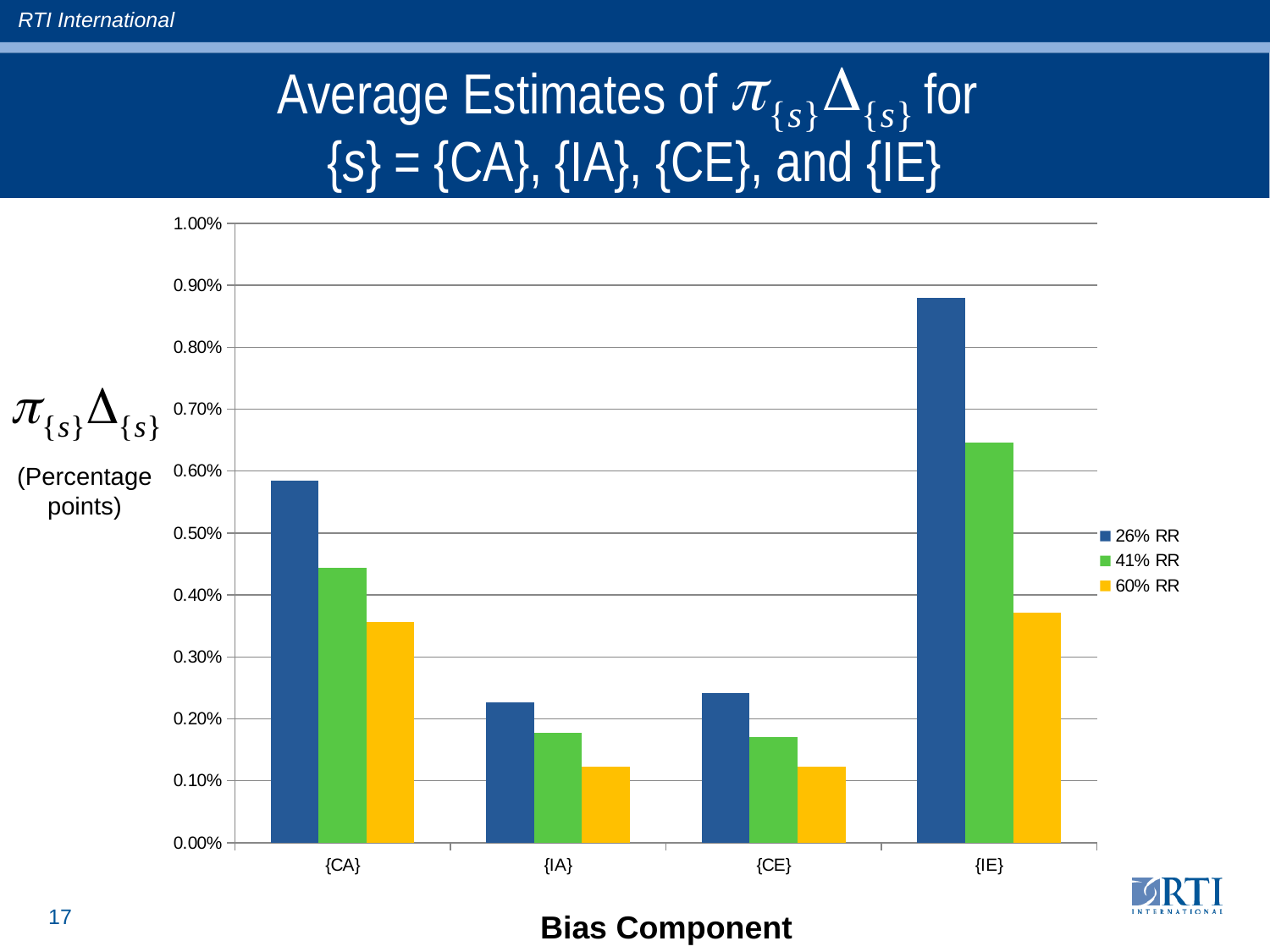
What is the title of the x axis? Bias Component Is the 26% RR value for {CA} greater or less than 0.50%? greater What kind of chart is shown on the slide? bar chart Is the 26% RR value for {IE} greater or less than 0.80%? greater Which bias component has the highest value for the 41% RR series? {IE} Is the 41% RR value for {IE} greater or less than 0.60%? greater For the 26% RR series, which is larger: the value for {CA} or the value for {IE}? {IE} For {IE}, which series has the larger value: 26% RR or 60% RR? 26% RR How many bias component categories are shown on the x axis? 4 How many series does the legend list? 3 Which bias component has the highest value for the 26% RR series? {IE}